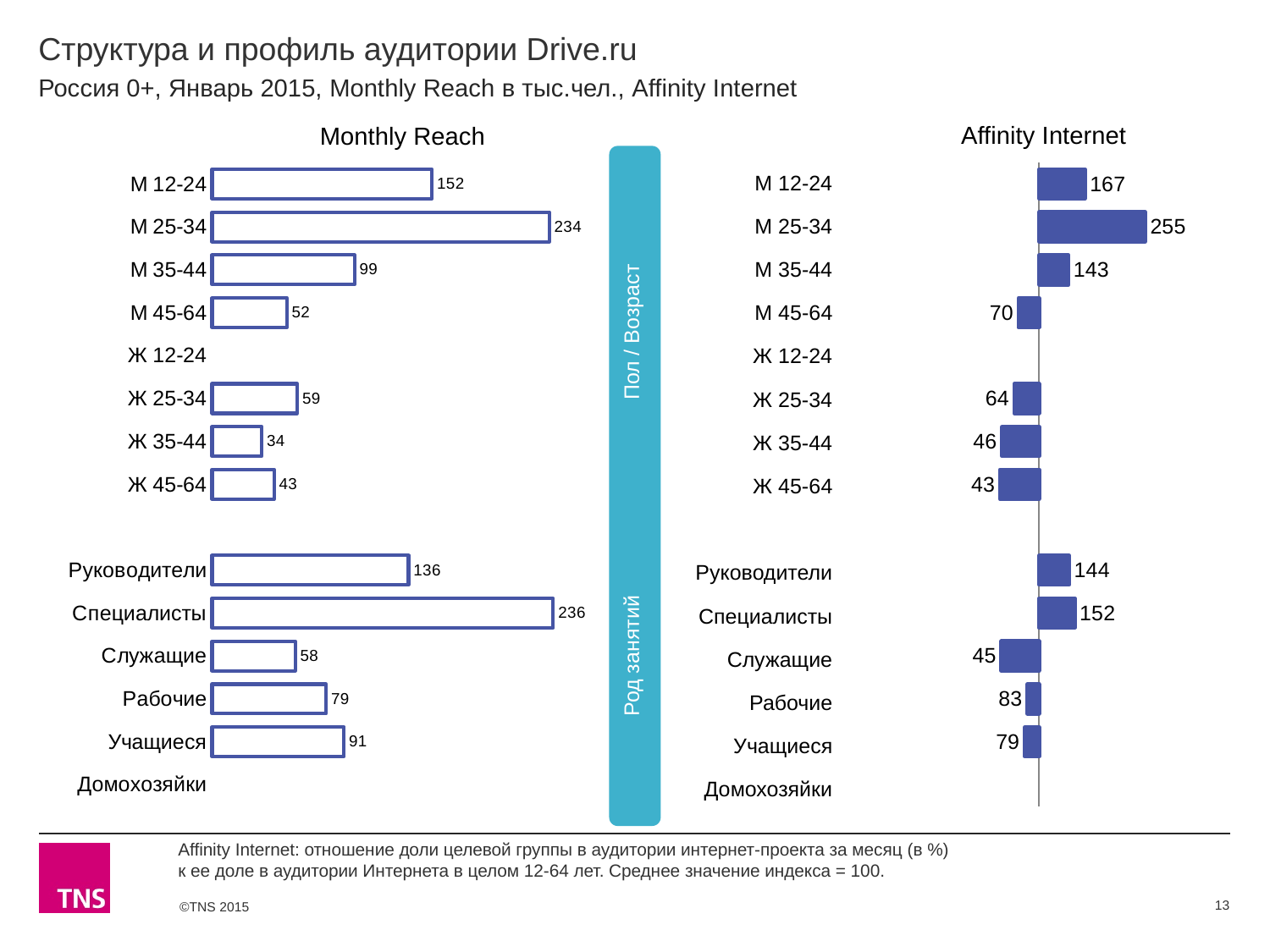
What type of chart is the Affinity Internet chart? Bar chart In the Affinity Internet chart, what is the value for Специалисты? 152 In the Affinity Internet chart, what is the difference between the values for Руководители and Служащие? 99 In the Monthly Reach chart, which category has the highest value? Специалисты In the Monthly Reach chart, what is the value for М 25-34? 234 In the Monthly Reach chart, what is the difference between the values for М 25-34 and М 12-24? 82 In the Affinity Internet chart, which category has the highest value? М 25-34 In the Monthly Reach chart, which is larger, the value for Руководители or the value for Служащие? Руководители In the Monthly Reach chart, which labelled category has the lowest value? Ж 35-44 In the Monthly Reach chart, what is the value for Учащиеся? 91 In the Affinity Internet chart, which labelled category has the lowest value? Ж 45-64 In the Affinity Internet chart, which is larger, the value for Рабочие or the value for Учащиеся? Рабочие